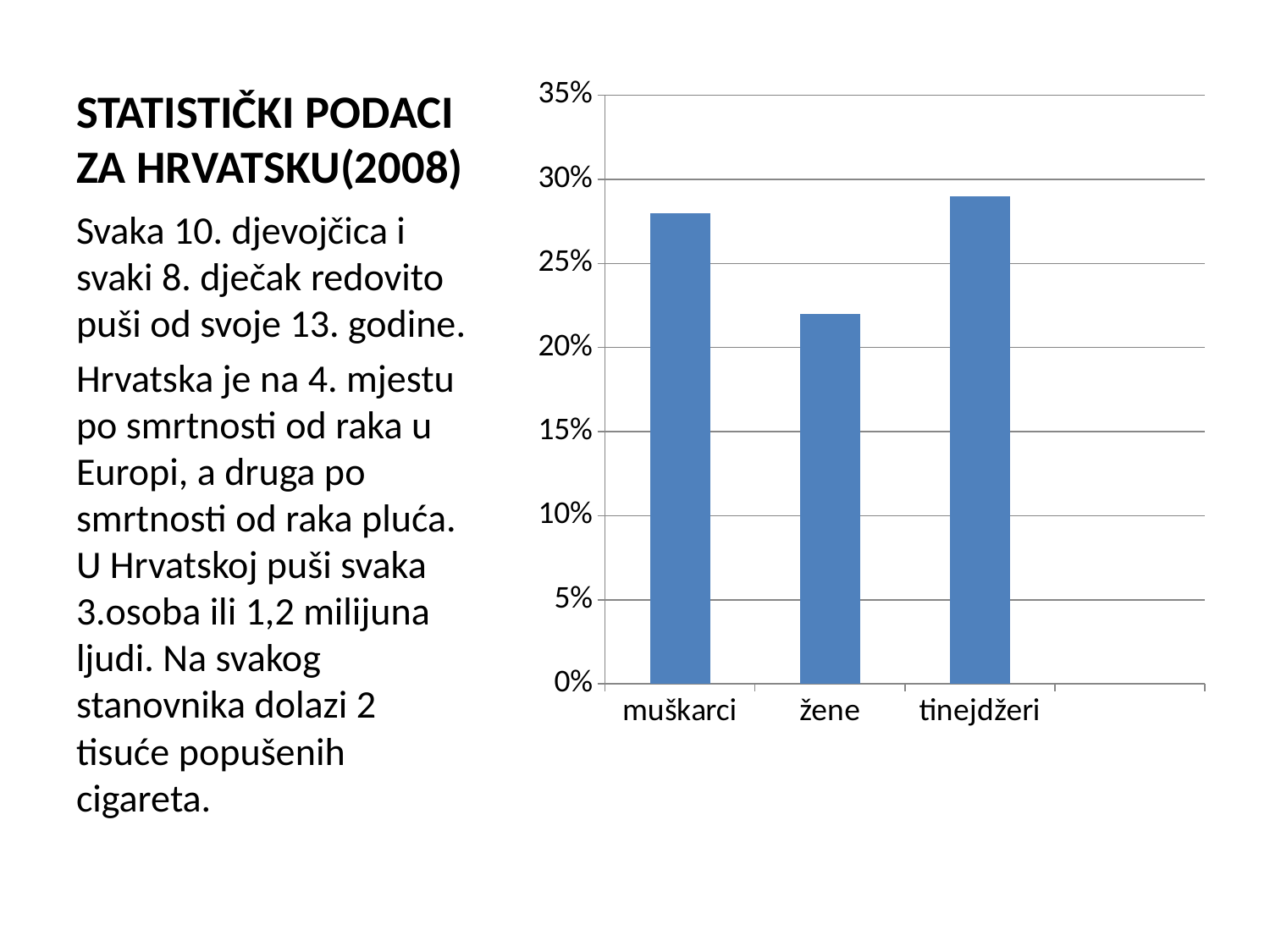
How many categories are shown on the x axis of the chart? 3 Is the value for tinejdžeri greater or less than 30%? less Is the value for tinejdžeri greater or less than 25%? greater Which category has the lowest value in the chart? žene What kind of chart is shown on the slide? bar chart Which is larger, the value for muškarci or the value for žene? muškarci Is the value for žene greater or less than 20%? greater What is the highest value shown on the vertical axis of the chart? 35% What is the label of the first category on the x axis of the chart? muškarci Which is larger, the value for žene or the value for tinejdžeri? tinejdžeri